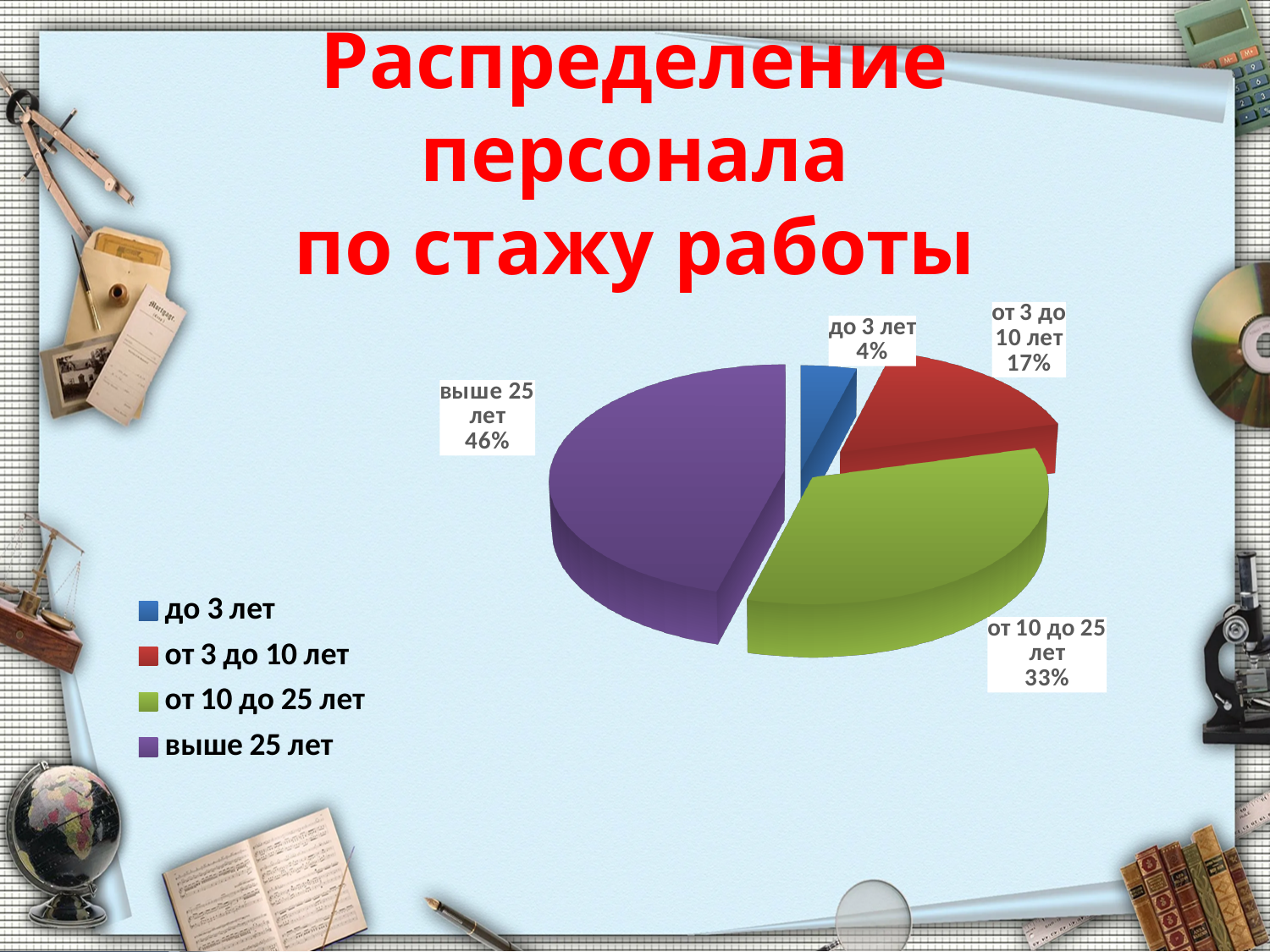
What is the value shown for "от 10 до 25 лет"? 33% What share of the pie does the "выше 25 лет" slice have? 46% How many categories does the pie chart have? 4 What is the difference between the shares of "выше 25 лет" and "от 10 до 25 лет"? 13% What colour is the slice for "от 10 до 25 лет"? Green What is the difference between the shares of "от 3 до 10 лет" and "до 3 лет"? 13% Which category has the smallest share of the pie? до 3 лет What is the value shown for "до 3 лет"? 4% What is the value shown for "от 3 до 10 лет"? 17% Which is larger: the share for "от 3 до 10 лет" or the share for "от 10 до 25 лет"? от 10 до 25 лет What type of chart is shown on the slide? Pie chart Which category has the largest share of the pie? выше 25 лет